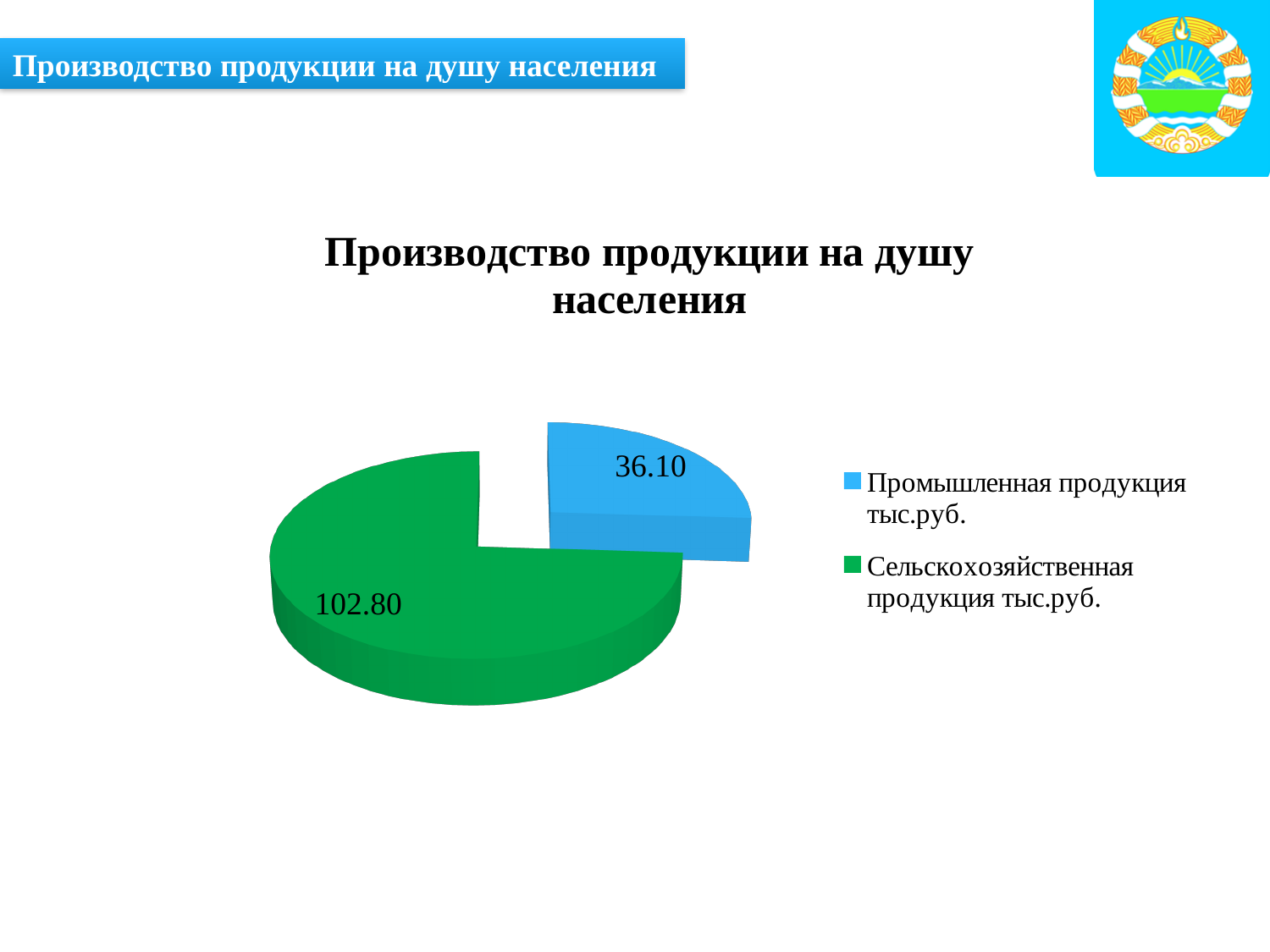
Which is larger: the value for Промышленная продукция or the value for Сельскохозяйственная продукция? Сельскохозяйственная продукция What is the total of the two values shown in the pie chart? 138.90 What is the title of the chart? Производство продукции на душу населения What is the value for Сельскохозяйственная продукция тыс.руб.? 102.80 How many slices does the pie chart have? 2 How many entries does the legend list? 2 Which category has the smallest slice of the pie? Промышленная продукция тыс.руб. What is the value for Промышленная продукция тыс.руб.? 36.10 What is the difference between the value for Сельскохозяйственная продукция and the value for Промышленная продукция? 66.70 What colour is the slice for Сельскохозяйственная продукция тыс.руб.? Green Which category has the largest slice of the pie? Сельскохозяйственная продукция тыс.руб. What type of chart is shown on the slide? Pie chart